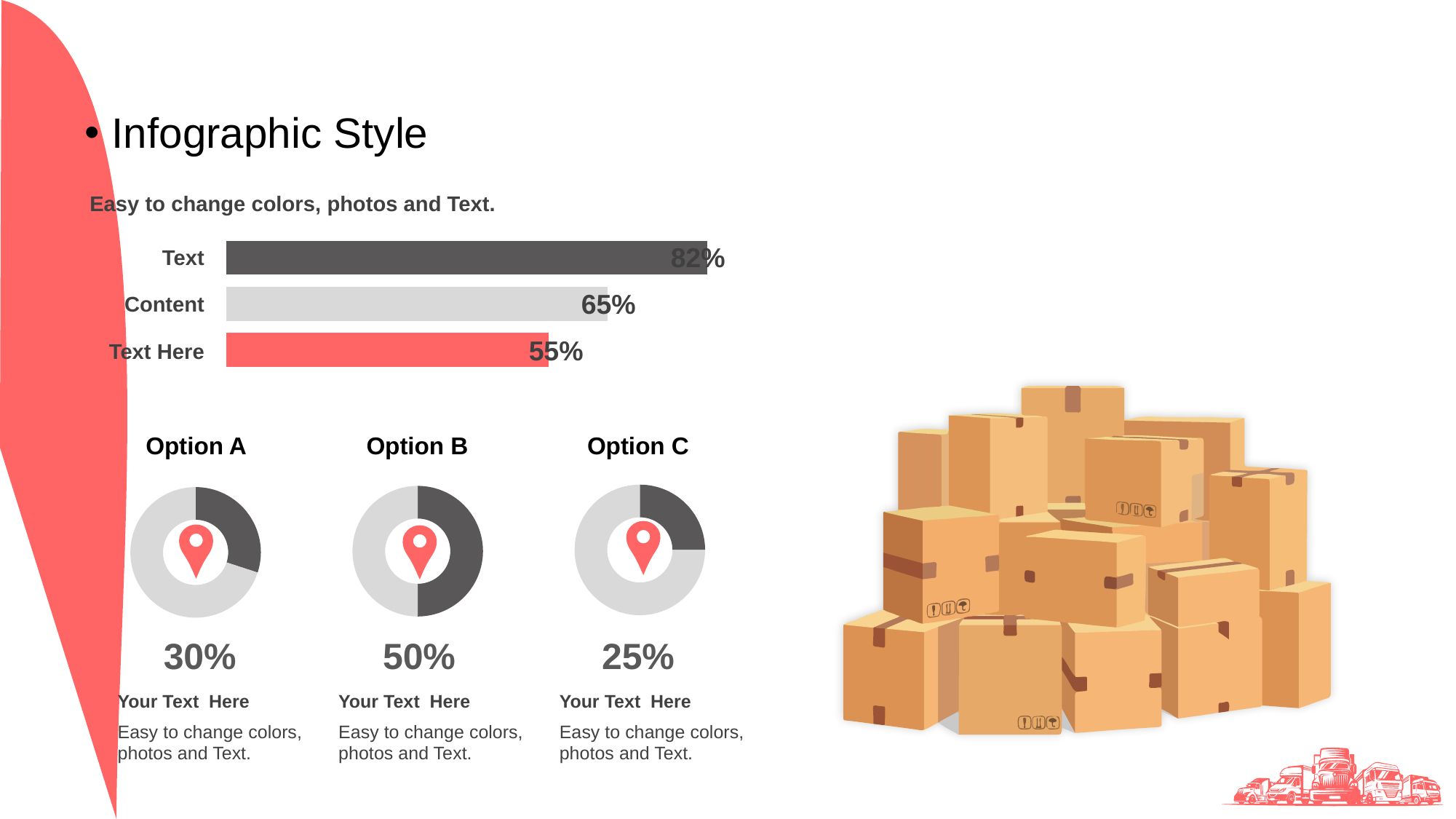
How many categories does the horizontal bar chart at the top show? 3 In the Option A donut chart, what percentage is shown? 30% In the horizontal bar chart at the top, what is the value for Content? 65% In the horizontal bar chart at the top, which is larger, the value for Content or the value for Text Here? Content In the horizontal bar chart at the top, what is the value for Text Here? 55% Which of the three donut charts, Option A, Option B or Option C, shows the highest percentage? Option B In the Option C donut chart, what percentage is shown? 25% In the horizontal bar chart at the top, which category has the highest value? Text In the horizontal bar chart at the top, what colour is the bar for Text Here? red What kind of chart is the chart at the top with the labels Text, Content and Text Here? bar chart In the horizontal bar chart at the top, what is the difference between the values for Text and Content? 17% In the horizontal bar chart at the top, which category has the lowest value? Text Here